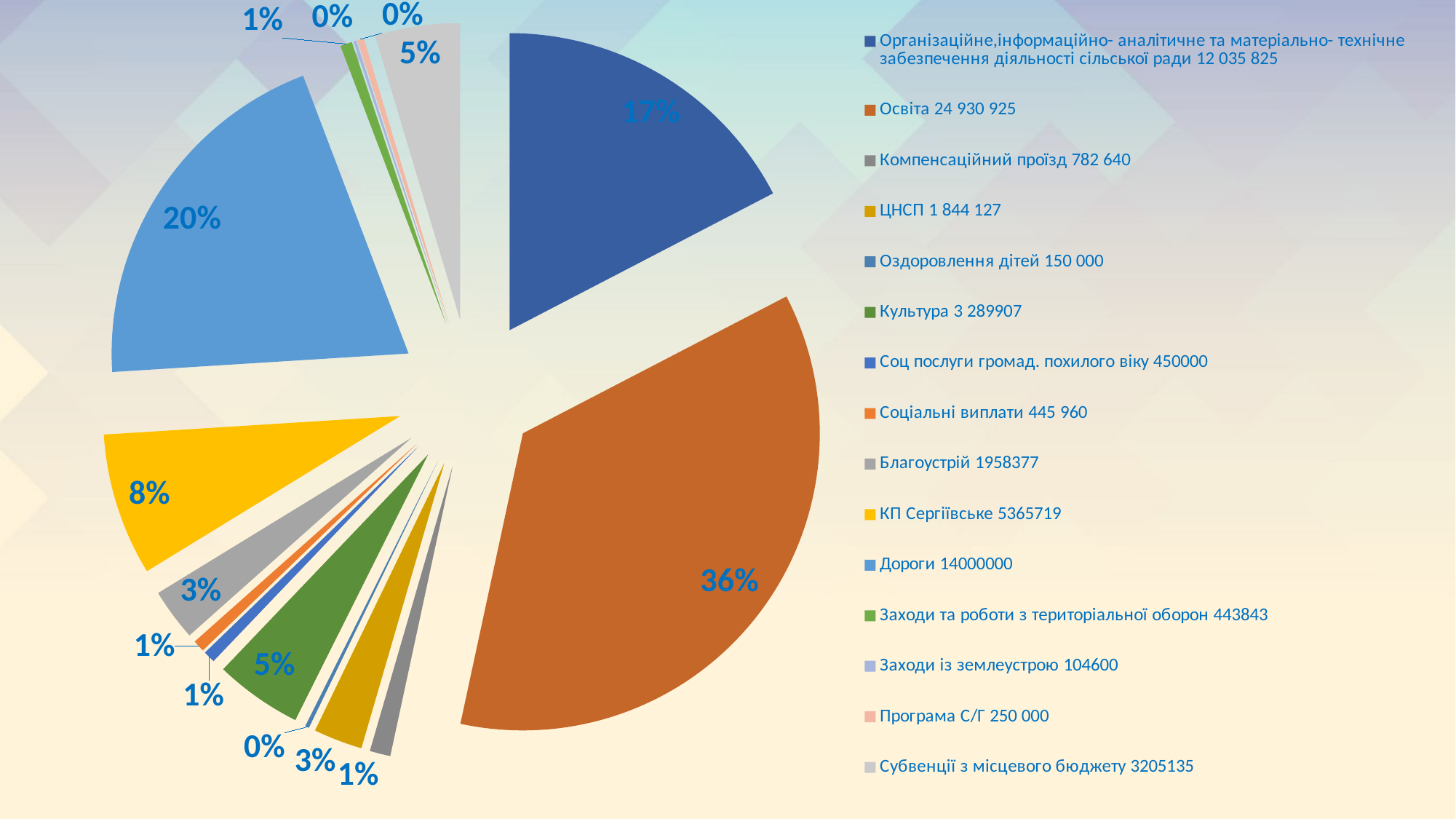
What value is shown in the legend for Дороги? 14000000 What share of the pie does Освіта represent? 36% Which category has the largest slice of the pie? Освіта How many categories does the pie chart's legend list? 15 What share of the pie does КП Сергіївське represent? 8% What kind of chart is shown on the slide? pie chart What share of the pie does Дороги represent? 20% What is the difference in percentage points between the Освіта slice and the Організаційне, інформаційно-аналітичне та матеріально-технічне забезпечення діяльності сільської ради slice? 19% What value is shown in the legend for Освіта? 24 930 925 Which slice is larger, Дороги or КП Сергіївське? Дороги Which category has the smallest value according to the legend? Заходи із землеустрою